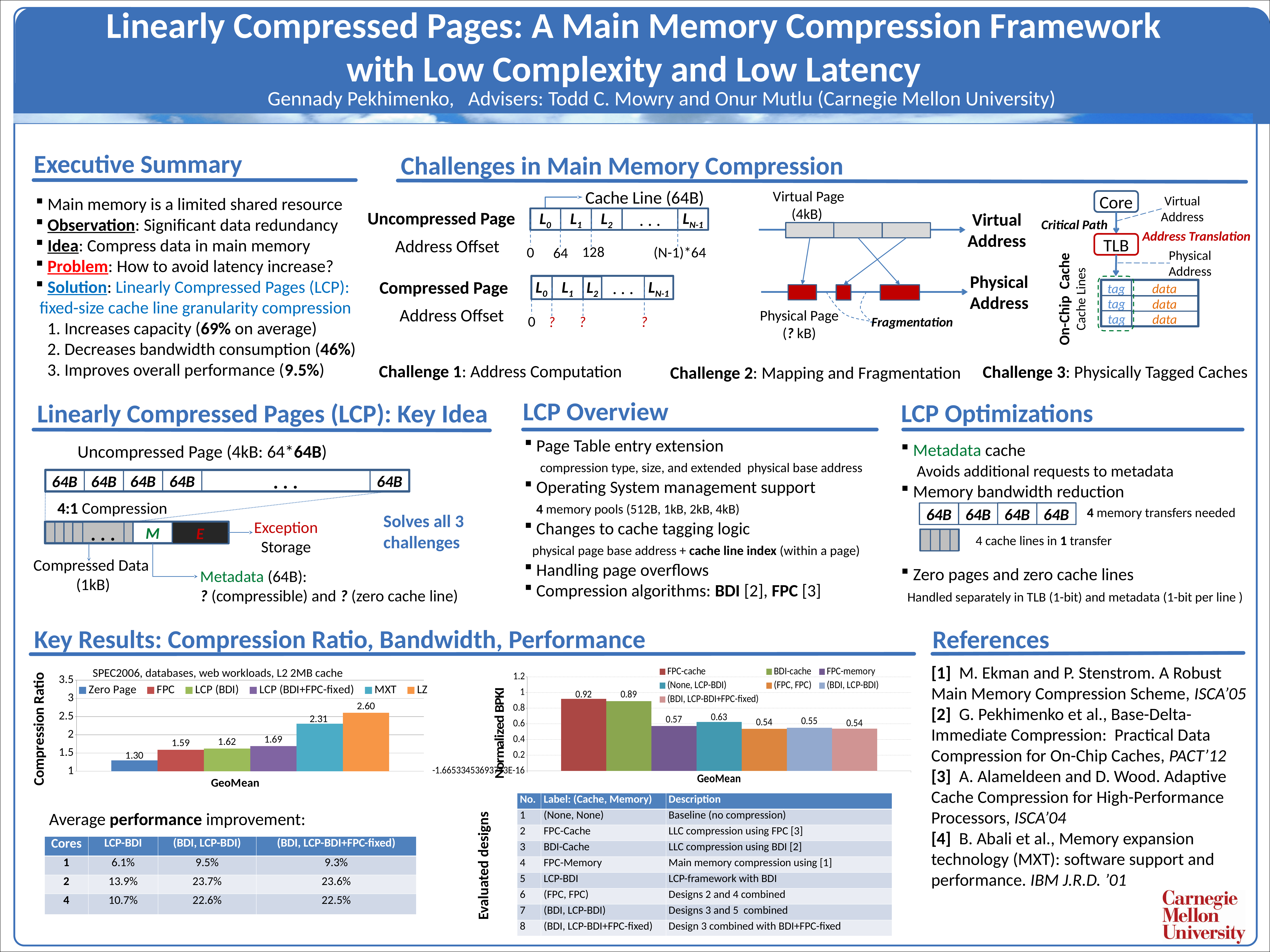
In the Normalized BPKI chart, what is the value for (None, LCP-BDI)? 0.63 In the Normalized BPKI chart, what is the value for FPC-cache? 0.92 In the Normalized BPKI chart, how many series does the legend list? 7 In the Compression Ratio chart, which series has the lowest compression ratio? Zero Page In the Compression Ratio chart, what is the compression ratio for LCP (BDI)? 1.62 In the Compression Ratio chart, how many series does the legend list? 6 In the Normalized BPKI chart, which series has the highest value? FPC-cache In the Compression Ratio chart, which series has the highest compression ratio? LZ In the Compression Ratio chart, what is the difference between the MXT and LCP (BDI+FPC-fixed) values? 0.62 In the Compression Ratio chart, what is the compression ratio for LZ? 2.60 In the Normalized BPKI chart, which is larger, FPC-memory or (None, LCP-BDI)? (None, LCP-BDI) What kind of chart is the Compression Ratio chart? bar chart